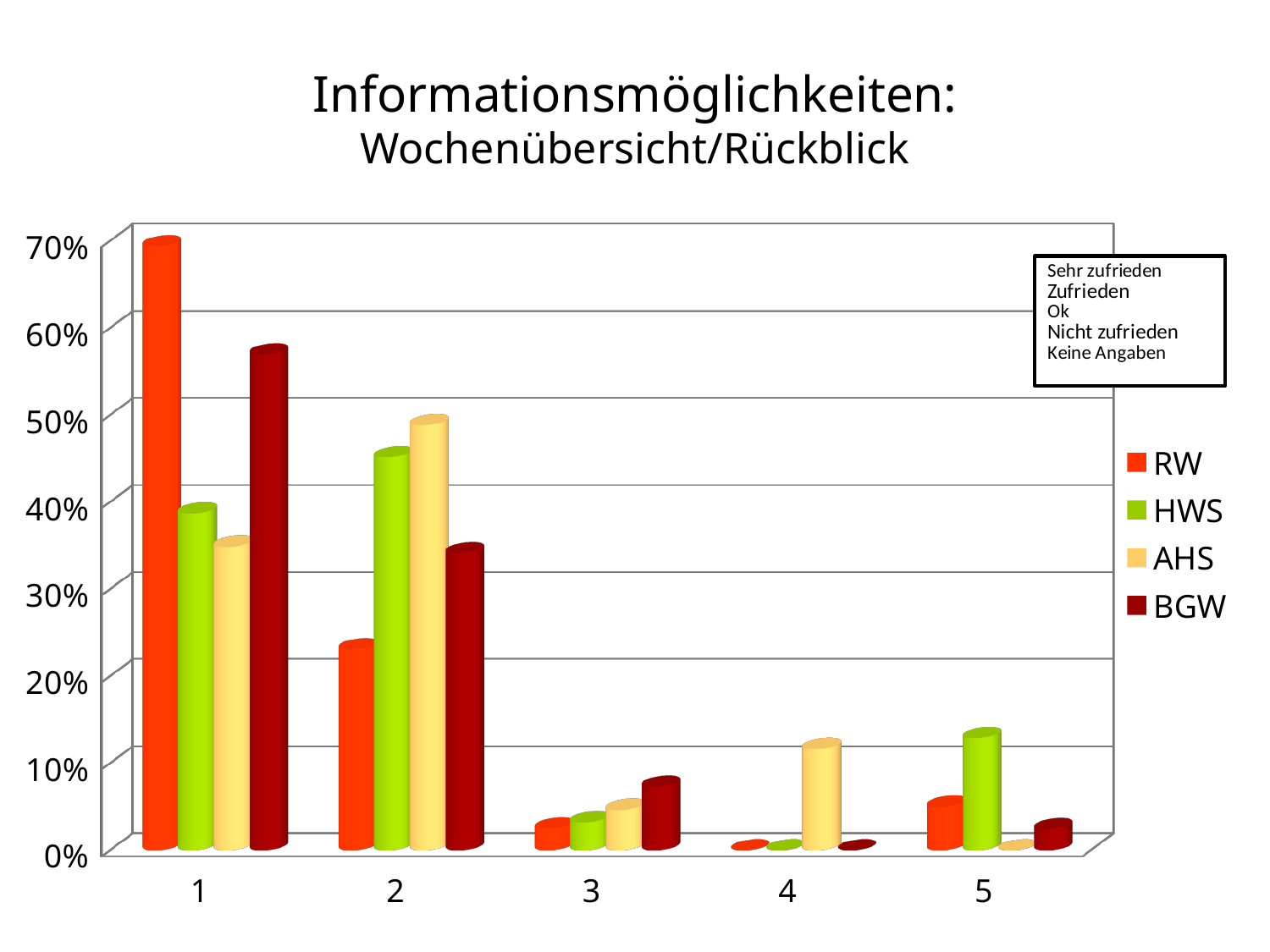
Which series has the highest value in category 4? AHS In category 1, which is larger, RW or HWS? RW Which series has the highest value in category 1? RW In which category does RW reach its highest value? 1 Is the value for RW in category 1 greater or less than 60%? greater How many categories are shown on the x axis? 5 What kind of chart is shown on the slide? bar chart Is the value for BGW in category 2 greater or less than 40%? less In category 2, which is larger, RW or BGW? BGW Is the value for HWS in category 5 greater or less than 10%? greater How many series does the legend list? 4